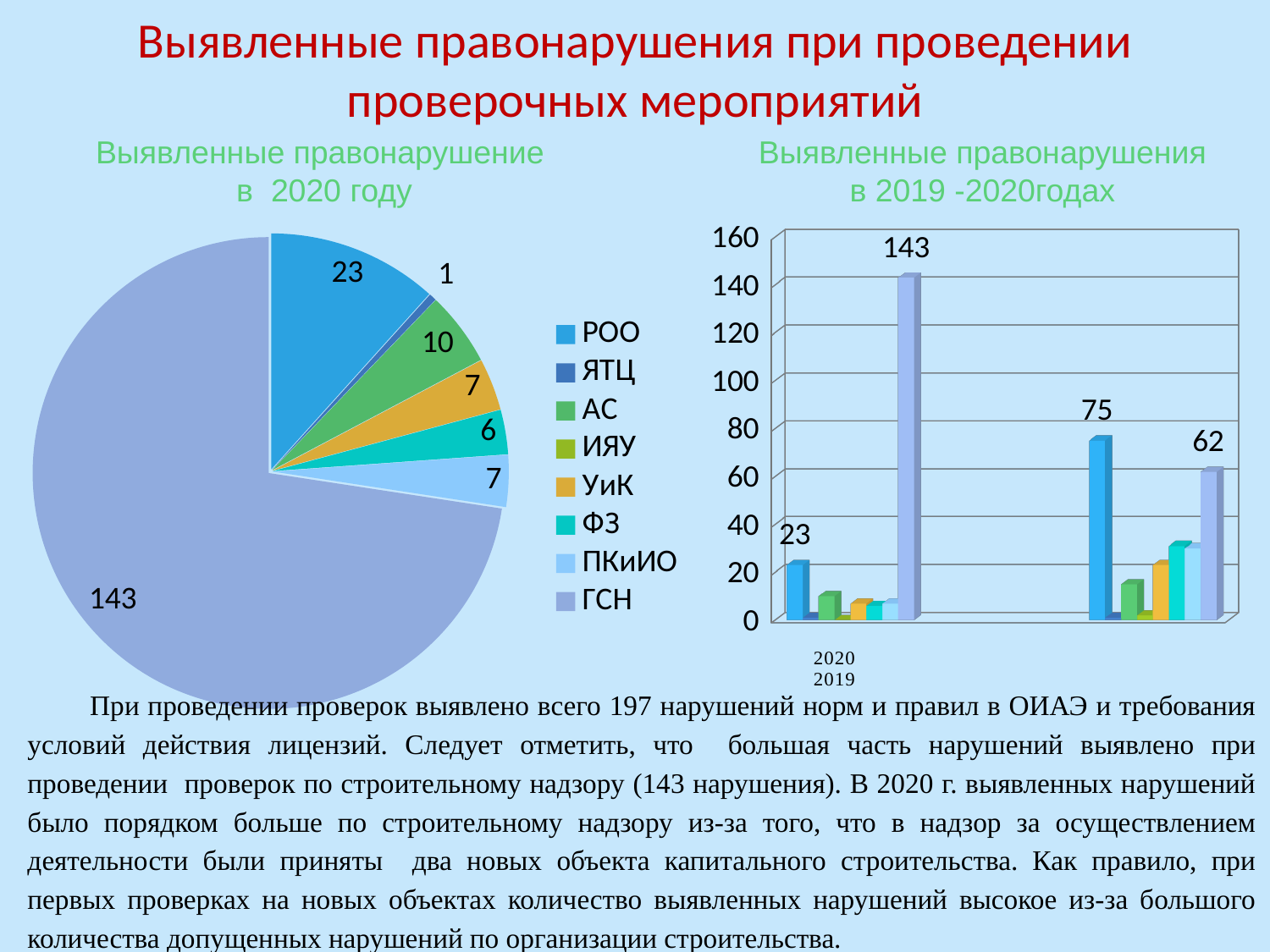
In the pie chart on the left, what value is shown for ГСН? 143 In the bar chart on the right, what is the difference between the labeled values 75 and 62 in the right-hand group of bars? 13 In the pie chart on the left, which labeled slice has the smallest value? ЯТЦ In the pie chart on the left, what value is shown for АС? 10 In the bar chart on the right, is the tallest bar in the left-hand group greater or less than 140? greater In the pie chart on the left, what is the difference between the values for ГСН and РОО? 120 In the bar chart on the right, what is the highest labeled value? 143 In the pie chart on the left, how many entries does the legend list? 8 In the pie chart on the left, what value is shown for РОО? 23 What kind of chart is the chart on the right, titled 'Выявленные правонарушения в 2019 -2020годах'? bar chart In the pie chart on the left, what value is shown for ЯТЦ? 1 In the pie chart on the left, which category has the largest slice? ГСН